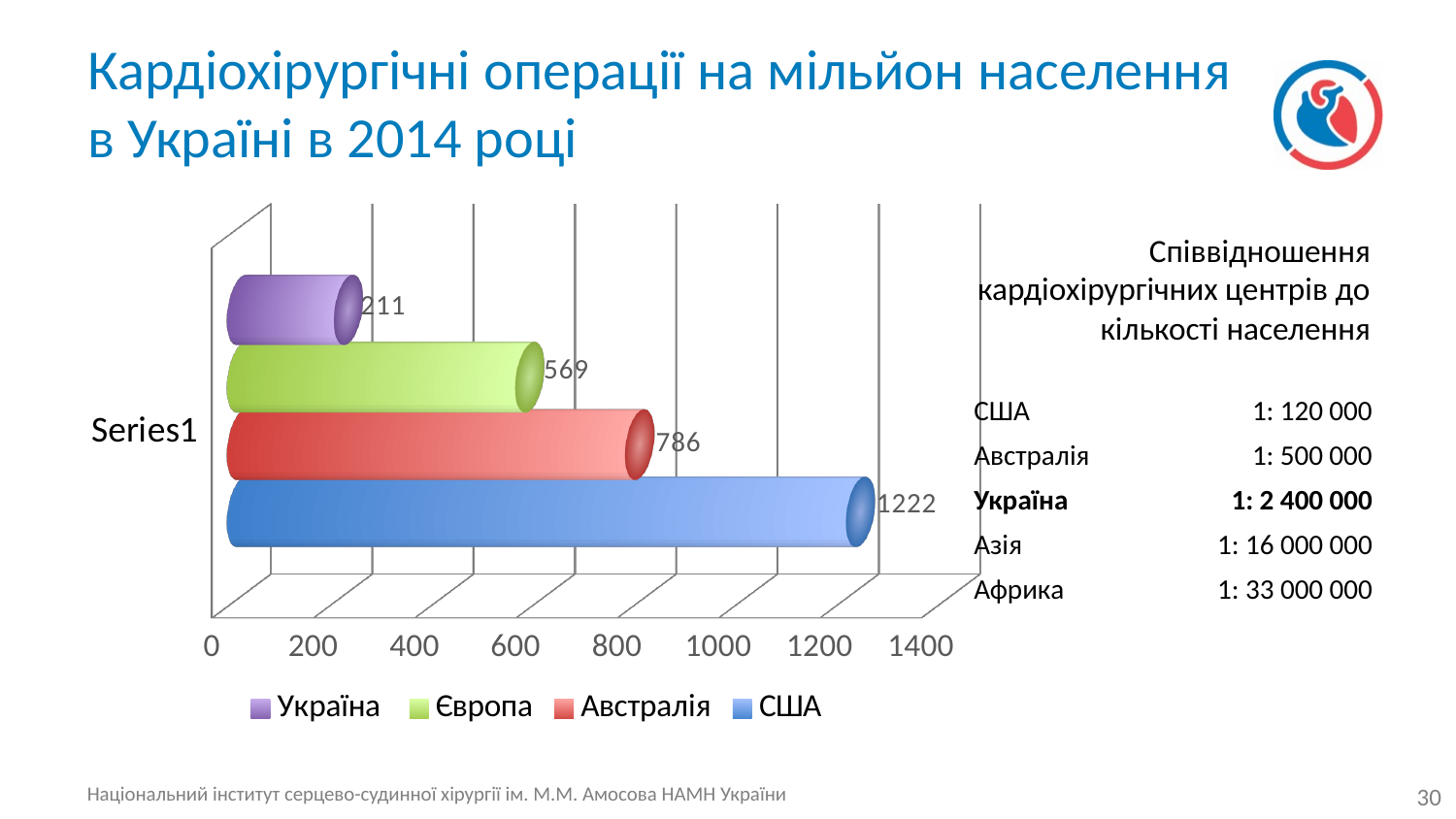
What kind of chart is shown on the slide? Bar chart Which series has the highest value on the chart? США How many series does the legend list? 4 Which is larger, the value for Європа or the value for Австралія? Австралія What is the difference between the values for Австралія and Європа? 217 What value is shown for Європа on the chart? 569 What colour is the bar for США in the chart? Blue What is the difference between the values for США and Україна? 1011 What value is shown for Австралія on the chart? 786 What value is shown for США on the chart? 1222 Which series has the lowest value on the chart? Україна What value is shown for Україна on the chart? 211